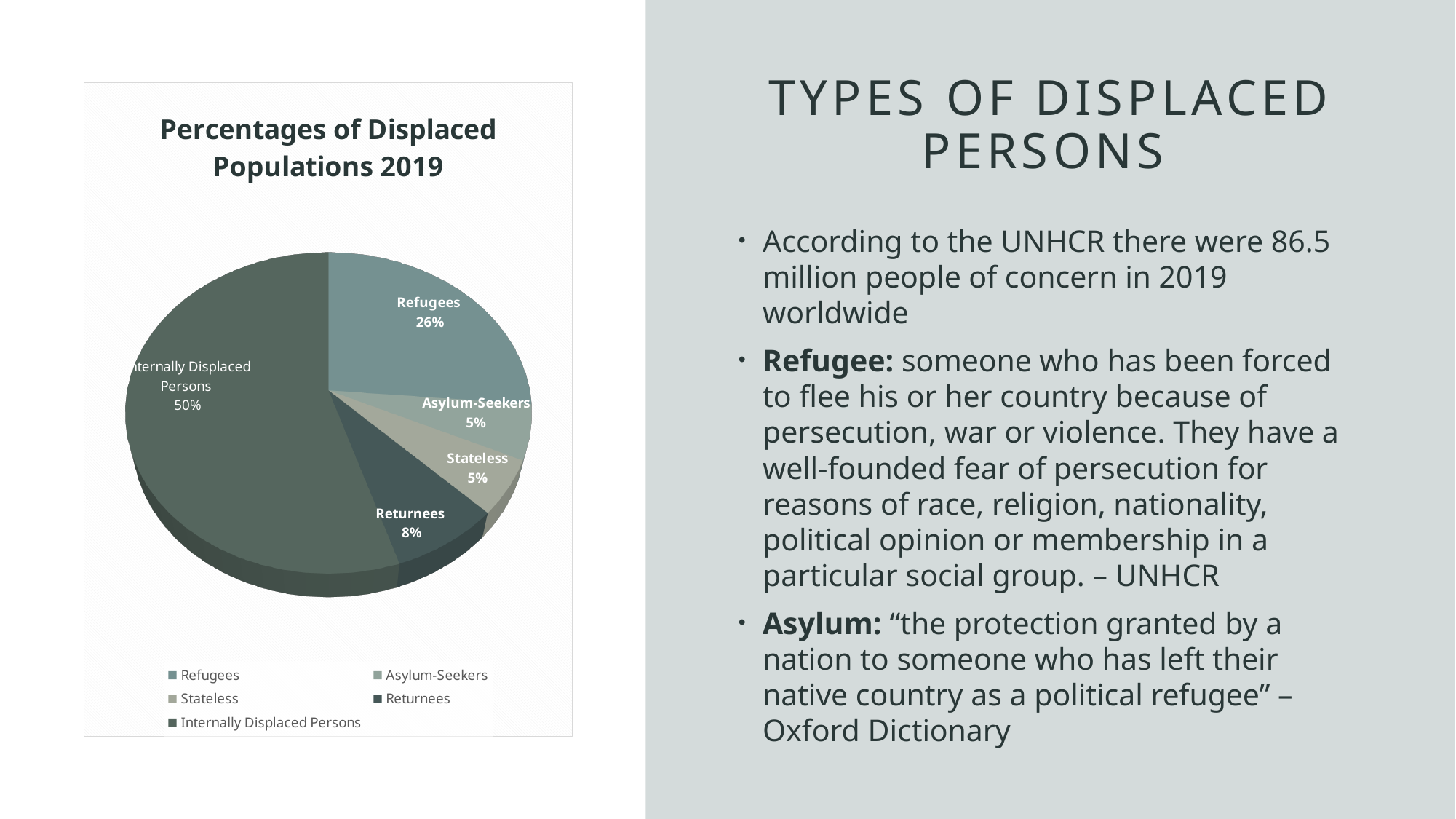
What is the difference in percentage points between Refugees and Returnees? 18 What percentage of the pie chart is Asylum-Seekers? 5% What percentage of the pie chart is Internally Displaced Persons? 50% What is the combined percentage of Asylum-Seekers and Stateless? 10% What kind of chart is shown on the slide? Pie chart What is the title of the chart? Percentages of Displaced Populations 2019 How many entries does the chart legend list? 5 What percentage of the pie chart is Refugees? 26% How many categories does the pie chart show? 5 What percentage of the pie chart is Returnees? 8% Which category has the largest share of the pie chart? Internally Displaced Persons Which is larger, the share for Refugees or the share for Returnees? Refugees